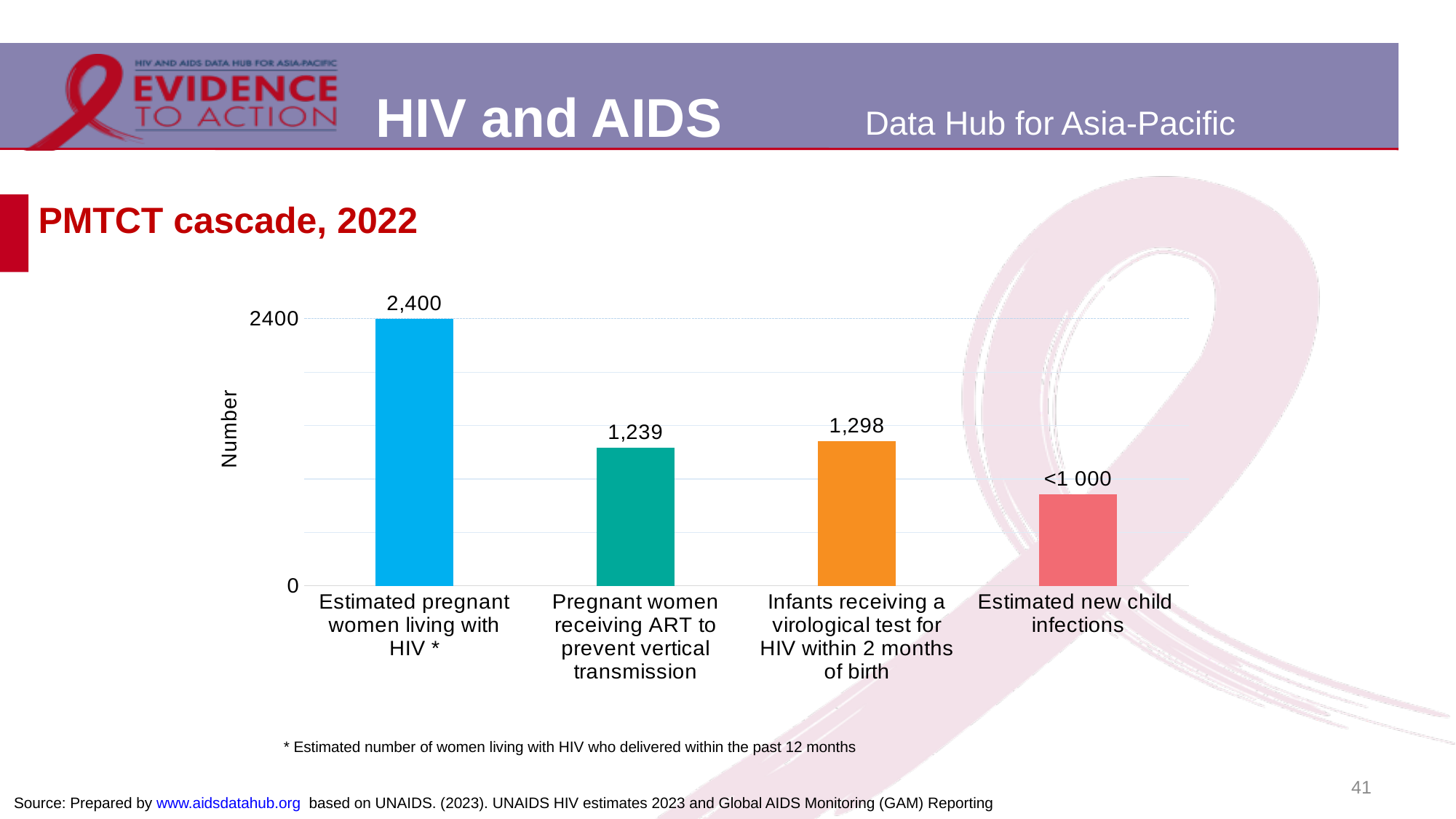
Which is larger: the value for Infants receiving a virological test for HIV within 2 months of birth or the value for Pregnant women receiving ART to prevent vertical transmission? Infants receiving a virological test for HIV within 2 months of birth What is the difference between the value for Estimated pregnant women living with HIV and the value for Pregnant women receiving ART to prevent vertical transmission? 1,161 What is the value for Estimated pregnant women living with HIV? 2,400 What is the value for Pregnant women receiving ART to prevent vertical transmission? 1,239 Which category has the lowest value? Estimated new child infections What is the value for Infants receiving a virological test for HIV within 2 months of birth? 1,298 What kind of chart is shown on the slide? Bar chart Which category has the highest value? Estimated pregnant women living with HIV What is the title of the chart? PMTCT cascade, 2022 What is the difference between the value for Infants receiving a virological test for HIV within 2 months of birth and the value for Pregnant women receiving ART to prevent vertical transmission? 59 How many categories are shown in the chart? 4 What is the value shown for Estimated new child infections? <1 000